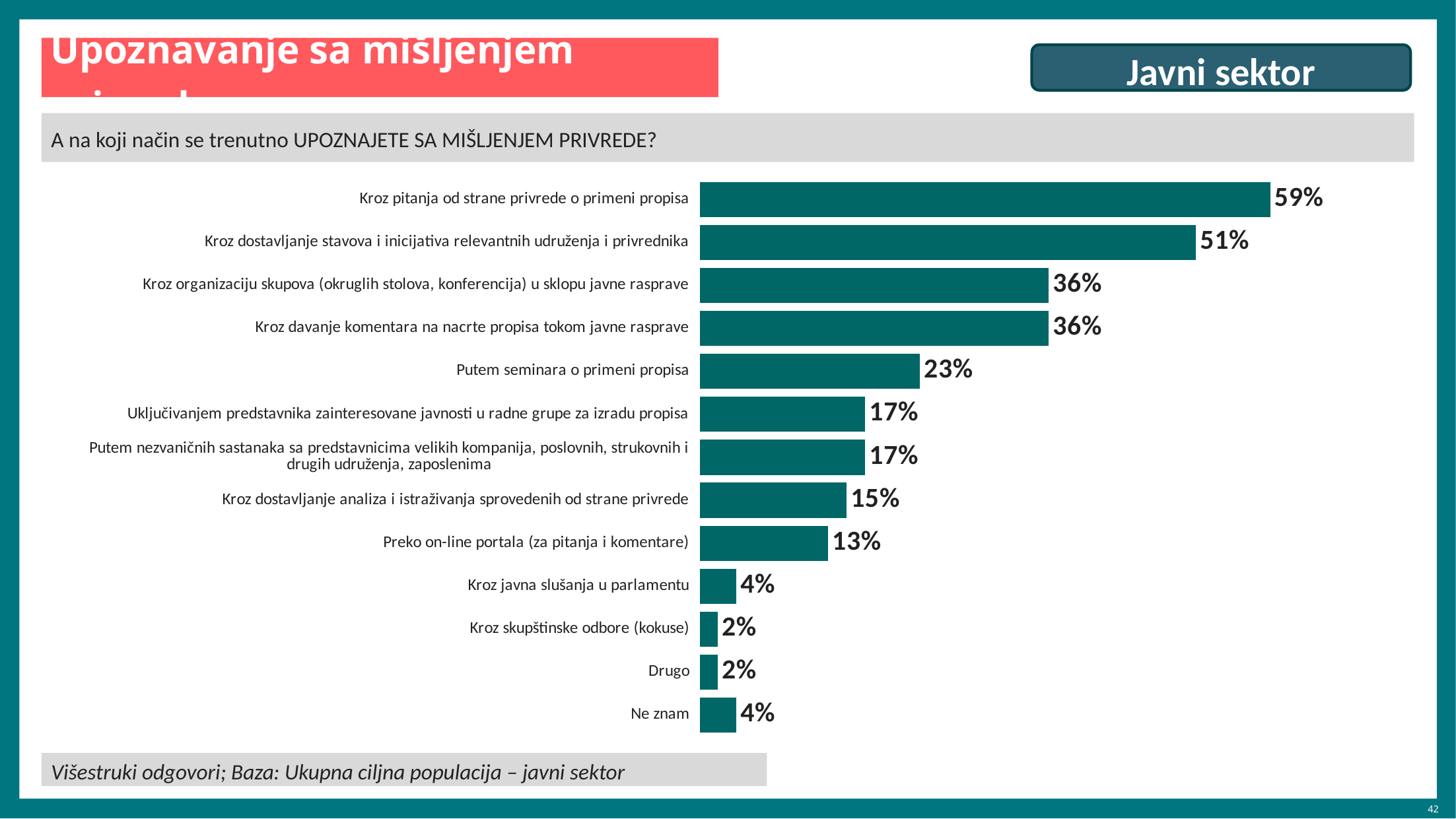
What is the value for "Kroz pitanja od strane privrede o primeni propisa"? 59% What colour are the bars in the chart? Dark teal What kind of chart is shown on the slide? Bar chart How many categories are shown in the chart? 13 Which is larger: "Preko on-line portala (za pitanja i komentare)" or "Kroz dostavljanje analiza i istraživanja sprovedenih od strane privrede"? Kroz dostavljanje analiza i istraživanja sprovedenih od strane privrede Which is larger: "Kroz javna slušanja u parlamentu" or "Kroz skupštinske odbore (kokuse)"? Kroz javna slušanja u parlamentu What is the value for "Ne znam"? 4% Which category has the highest value? Kroz pitanja od strane privrede o primeni propisa What is the value for "Preko on-line portala (za pitanja i komentare)"? 13% What is the difference between "Kroz pitanja od strane privrede o primeni propisa" and "Kroz dostavljanje stavova i inicijativa relevantnih udruženja i privrednika"? 8% What is the value for "Putem seminara o primeni propisa"? 23% What is the difference between "Putem seminara o primeni propisa" and "Kroz dostavljanje analiza i istraživanja sprovedenih od strane privrede"? 8%